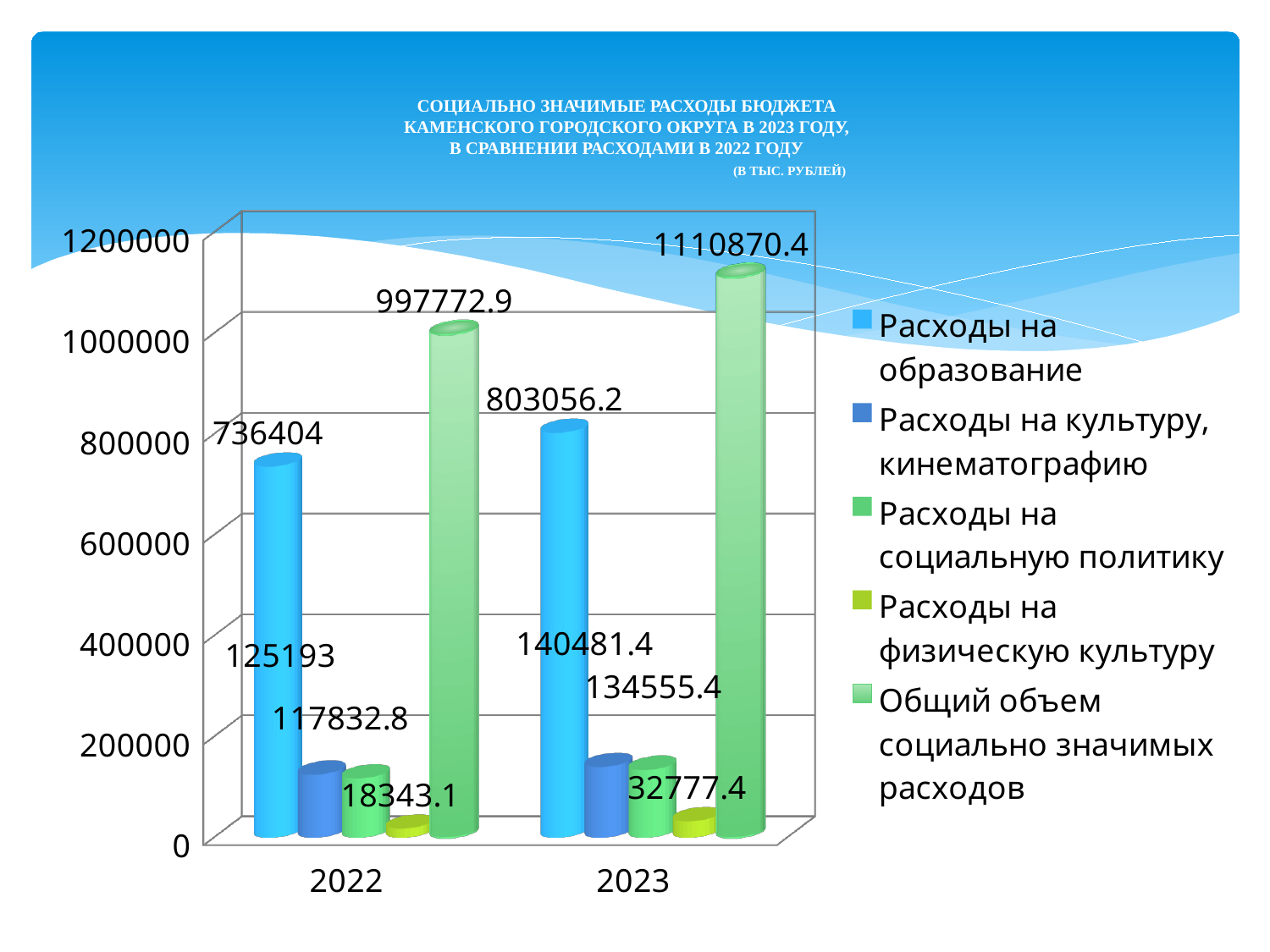
What is the value for 'Расходы на социальную политику' in 2022? 117832.8 What is the value for 'Расходы на культуру, кинематографию' in 2023? 140481.4 Which series has the lowest value in 2023? Расходы на физическую культуру What is the difference between 'Общий объем социально значимых расходов' in 2023 and in 2022? 113097.5 What is the value for 'Расходы на физическую культуру' in 2022? 18343.1 Which series has the highest value in 2022? Общий объем социально значимых расходов What is the value for 'Общий объем социально значимых расходов' in 2023? 1110870.4 What is the value for 'Расходы на образование' in 2022? 736404 What kind of chart is shown on the slide? Bar chart How many series does the legend list? 5 Which is larger: 'Расходы на физическую культуру' in 2022 or in 2023? 2023 What is the difference between 'Расходы на образование' in 2023 and in 2022? 67052.2